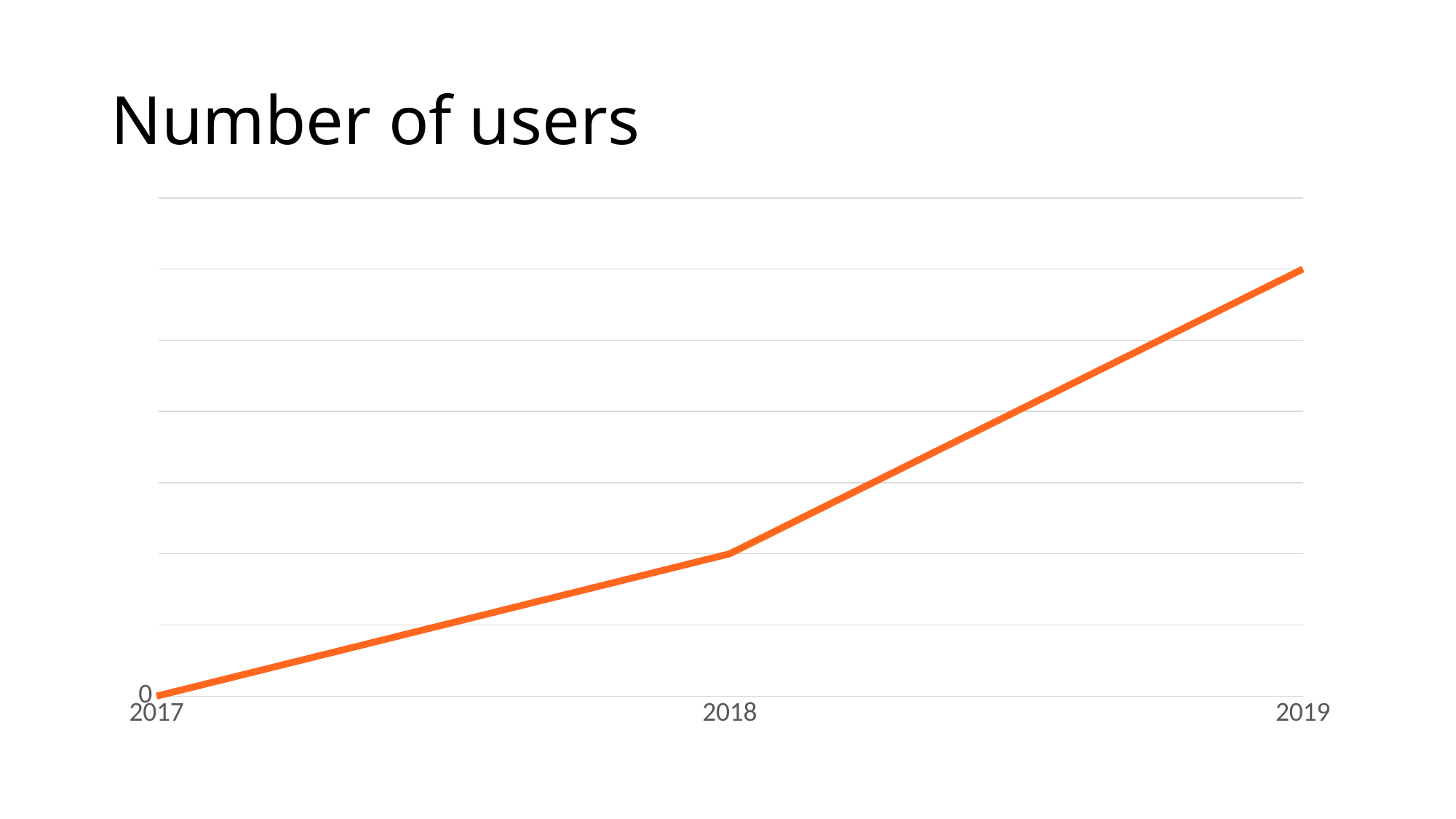
What is the title of the chart? Number of users What colour is the line in the chart? orange Do the values rise or fall from 2017 to 2019? rise How many years are plotted on the x axis of the chart? 3 Is the value for 2018 greater or less than 0? greater Which year has the highest number of users? 2019 Which year has more users, 2018 or 2019? 2019 What is the number of users in 2017? 0 What is the first year shown on the x axis? 2017 Which year has more users, 2017 or 2018? 2018 What kind of chart is shown on the slide? line chart Which year has the lowest number of users? 2017